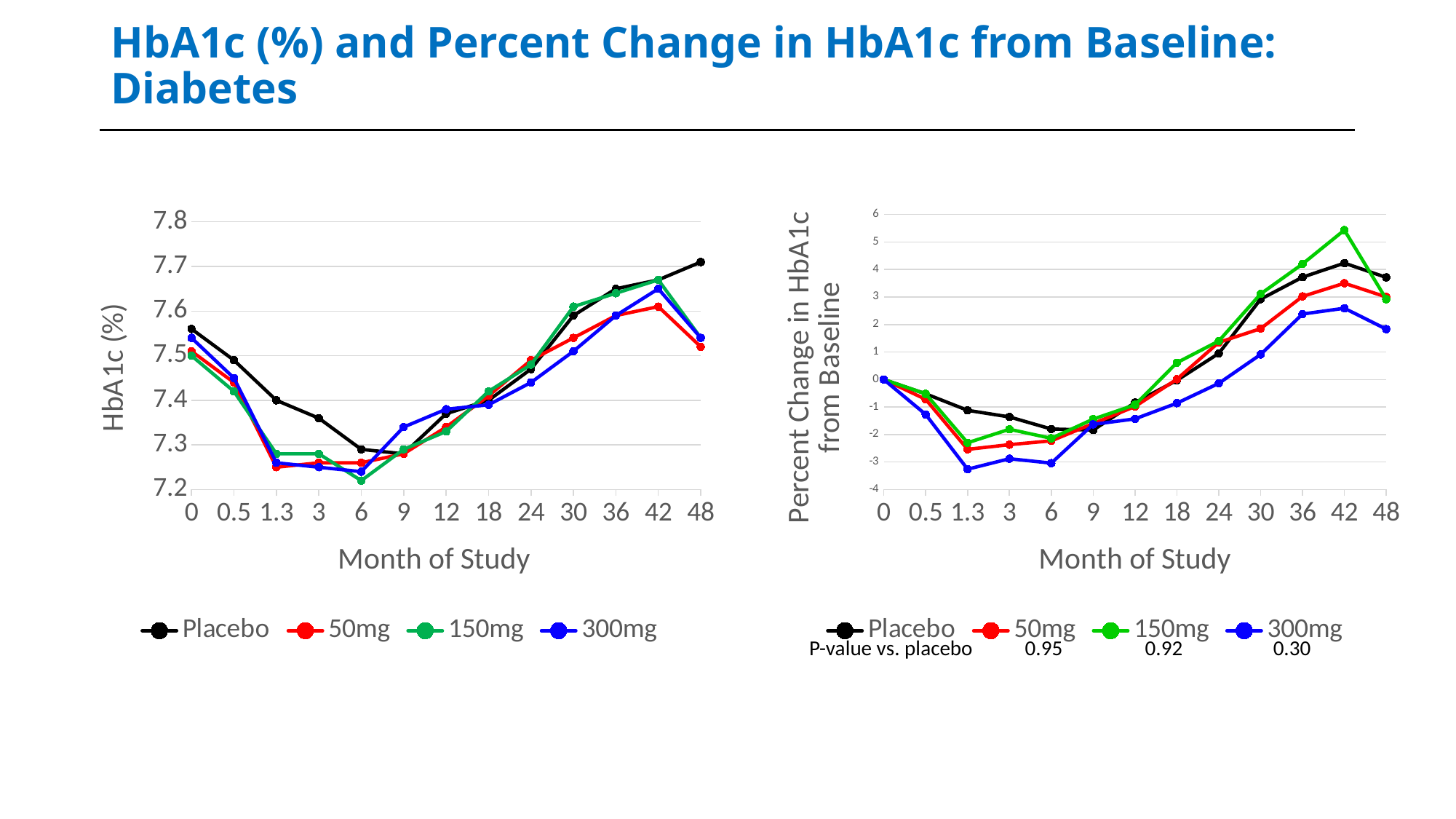
What P-value vs. placebo is shown for the 300mg group under the right chart? 0.30 How many months of study are marked along the x axis of the right chart? 13 In the right chart, which series has the lowest percent change at month 1.3? 300mg In the left chart, is the 150mg value at month 6 greater or less than 7.3? less In the right chart, does the Placebo line rise or fall between month 6 and month 42? rise What kind of chart is the left chart, HbA1c (%) versus Month of Study? line chart How many series does the legend of the left chart list? 4 In the left chart, which series has the highest HbA1c value at month 48? Placebo In the right chart, what is the percent change from baseline for all series at month 0? 0 In the right chart, which series has the highest percent change at month 42? 150mg In the right chart, is the 150mg value at month 42 greater or less than 5? greater In the left chart, is the Placebo value at month 0 greater or less than 7.5? greater